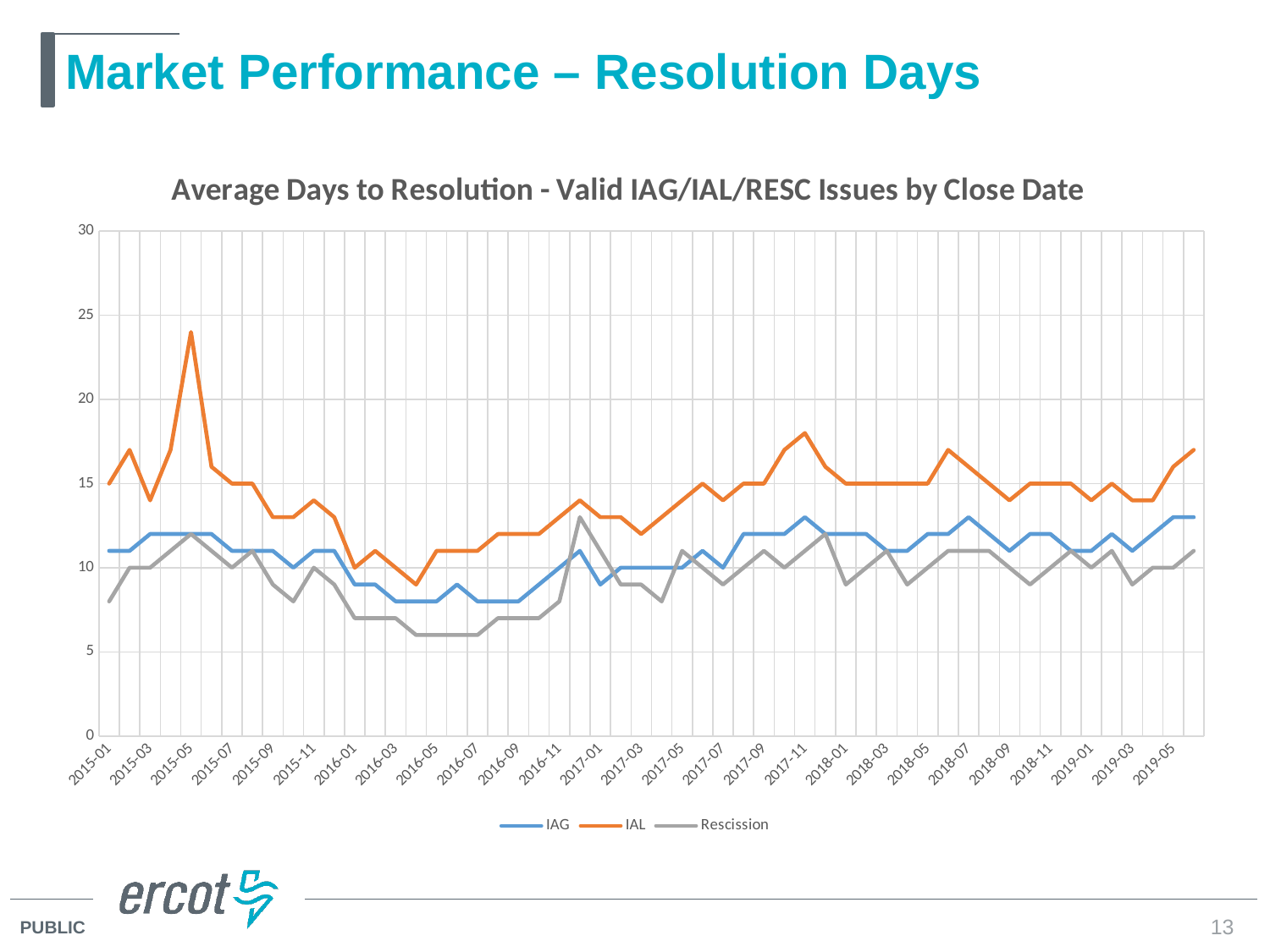
At 2016-05, which of the three series has the lowest value? Rescission How many series does the legend list? 3 Is the value for IAG at 2019-05 greater or less than 10? greater Which series reaches the highest value anywhere on the chart? IAL What is the title of the chart? Average Days to Resolution - Valid IAG/IAL/RESC Issues by Close Date What kind of chart is shown on the slide? Line chart Is the value for IAL at 2017-11 greater or less than 15? greater Is the value for Rescission at 2016-05 greater or less than 10? less What are the three series named in the legend? IAG, IAL, Rescission In which month does the IAL series reach its peak? 2015-05 At 2015-05, which series has the higher value, IAL or IAG? IAL